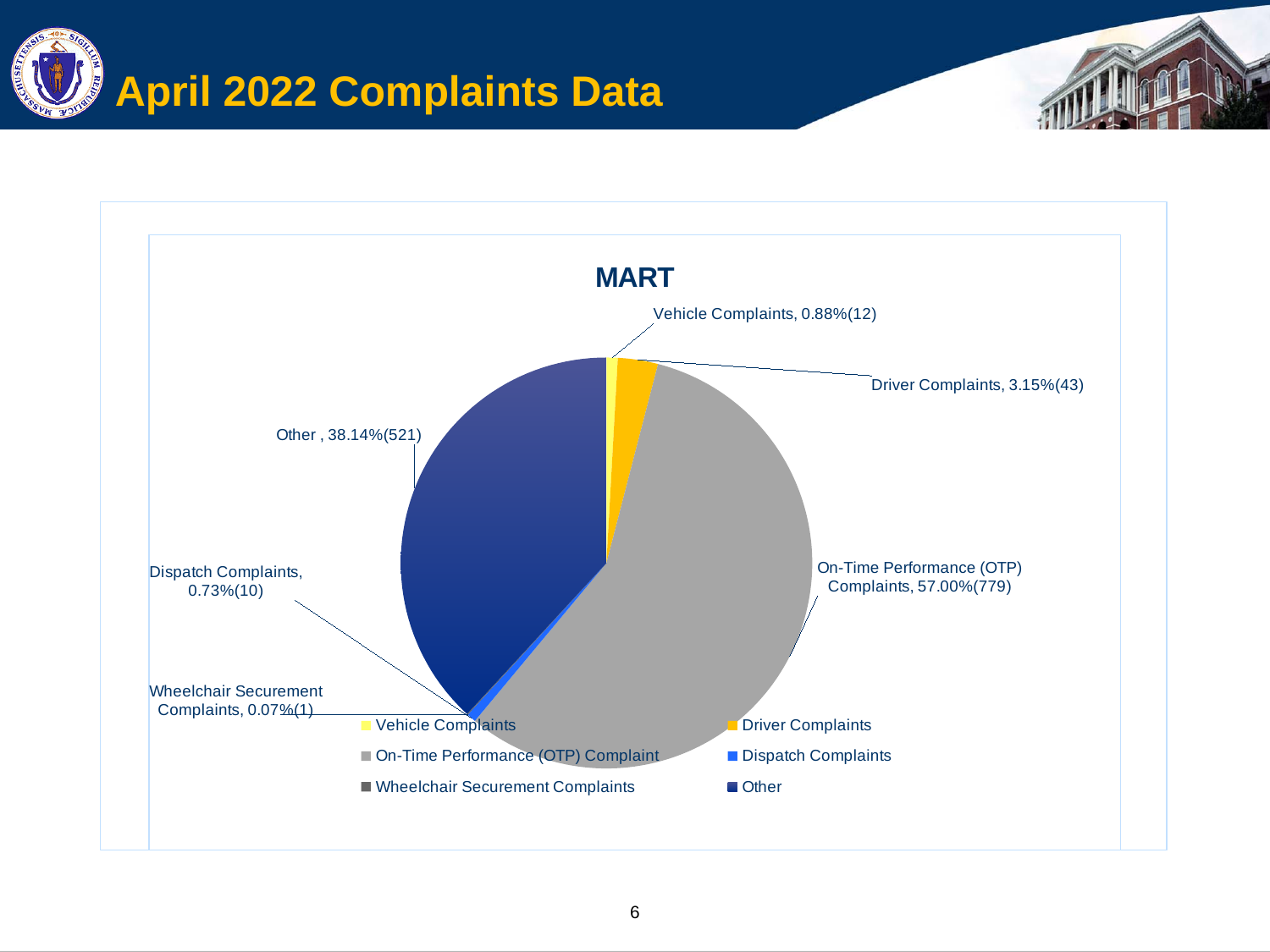
What type of chart is shown on the slide? Pie chart What is the title of the chart? MART What percentage is labelled for Other in the MART chart? 38.14% What percentage is labelled for Dispatch Complaints in the MART chart? 0.73% How many categories does the legend of the MART pie chart list? 6 How many Driver Complaints are shown in the MART chart? 43 Which is larger in the MART chart: Driver Complaints or Dispatch Complaints? Driver Complaints Which category has the smallest slice of the MART pie chart? Wheelchair Securement Complaints Which category has the largest slice of the MART pie chart? On-Time Performance (OTP) Complaints What share of the pie do On-Time Performance (OTP) Complaints represent? 57.00% What is the difference in count between On-Time Performance (OTP) Complaints and Other in the MART chart? 258 How many Vehicle Complaints are shown in the MART chart? 12